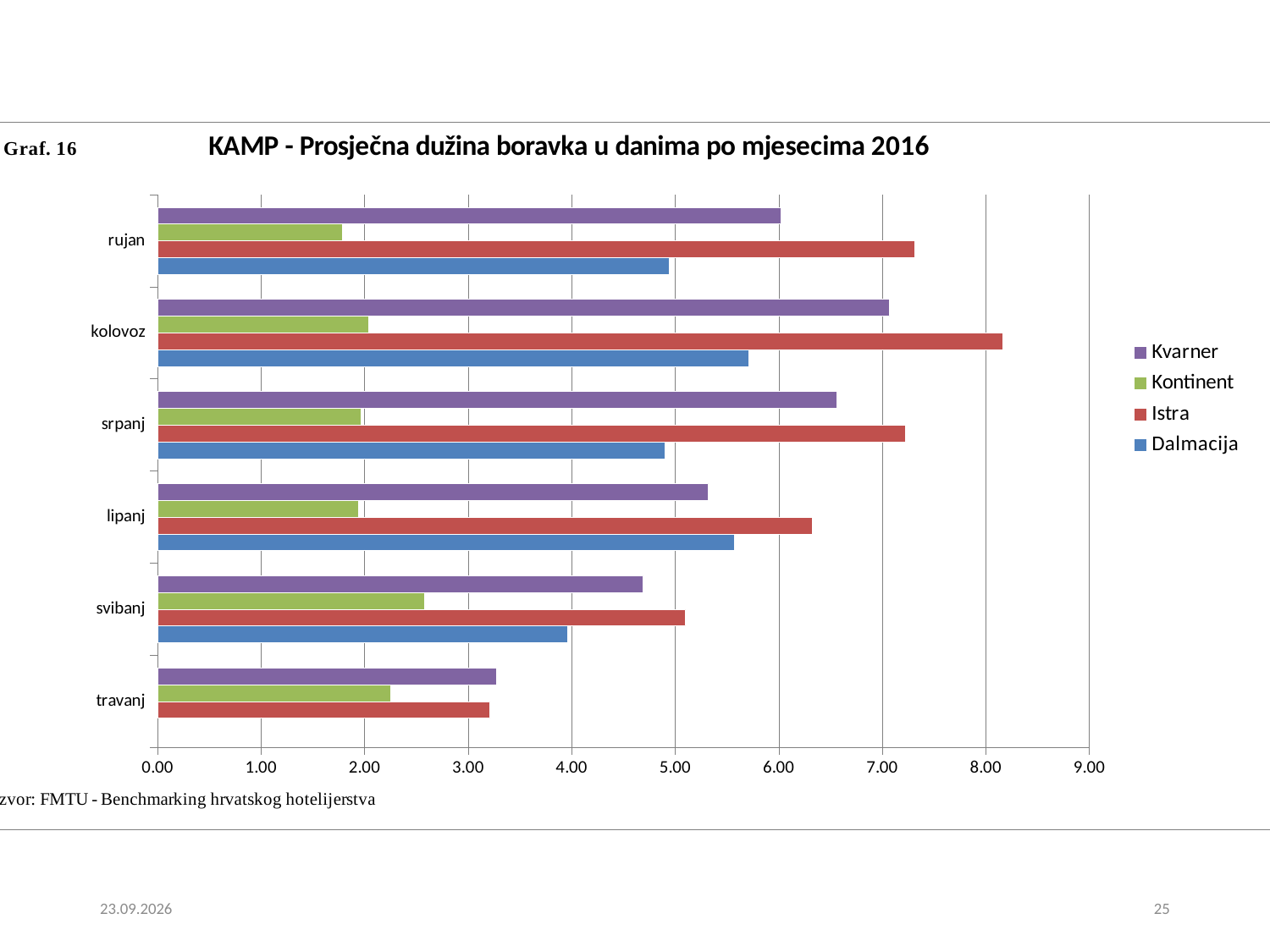
What kind of chart is shown on the slide? bar chart Is the value for Istra in kolovoz greater or less than 8.00? greater Is the value for Dalmacija in kolovoz greater or less than 5.00? greater Which series has the lowest value in travanj? Kontinent Is the value for Kontinent in rujan greater or less than 2.00? less How many series does the legend list? 4 What is the title of the chart? KAMP - Prosječna dužina boravka u danima po mjesecima 2016 Which series is shown in red in the legend? Istra How many months (categories) are shown on the chart? 6 Which month has the highest value for Istra? kolovoz Which series has the highest value in kolovoz? Istra In rujan, which is larger: the value for Kvarner or the value for Istra? Istra